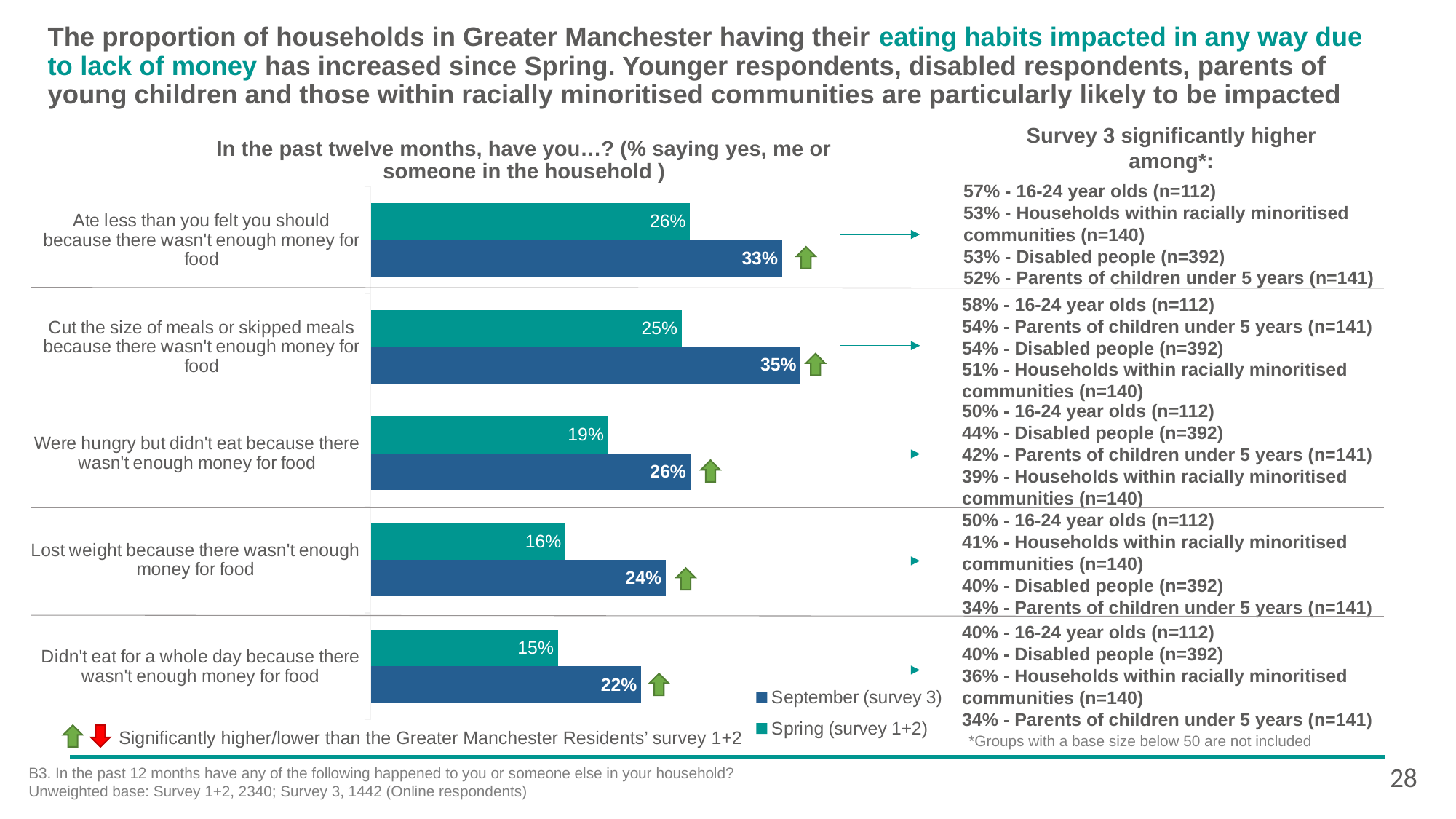
What is the September (survey 3) value for 'Didn't eat for a whole day because there wasn't enough money for food'? 22% Which category has the lowest Spring (survey 1+2) value? Didn't eat for a whole day because there wasn't enough money for food Which colour represents September (survey 3) in the chart? Dark blue What is the Spring (survey 1+2) value for 'Lost weight because there wasn't enough money for food'? 16% Which category has the highest September (survey 3) value? Cut the size of meals or skipped meals because there wasn't enough money for food What is the difference between the September (survey 3) and Spring (survey 1+2) values for 'Cut the size of meals or skipped meals because there wasn't enough money for food'? 10 percentage points What percentage said yes to 'Ate less than you felt you should because there wasn't enough money for food' in September (survey 3)? 33% How many categories (questions) are shown in the bar chart? 5 How many series does the chart legend list? 2 What kind of chart is shown on the slide? Bar chart Which is larger for 'Were hungry but didn't eat because there wasn't enough money for food': the September (survey 3) value or the Spring (survey 1+2) value? September (survey 3) What percentage said yes to 'Cut the size of meals or skipped meals because there wasn't enough money for food' in Spring (survey 1+2)? 25%